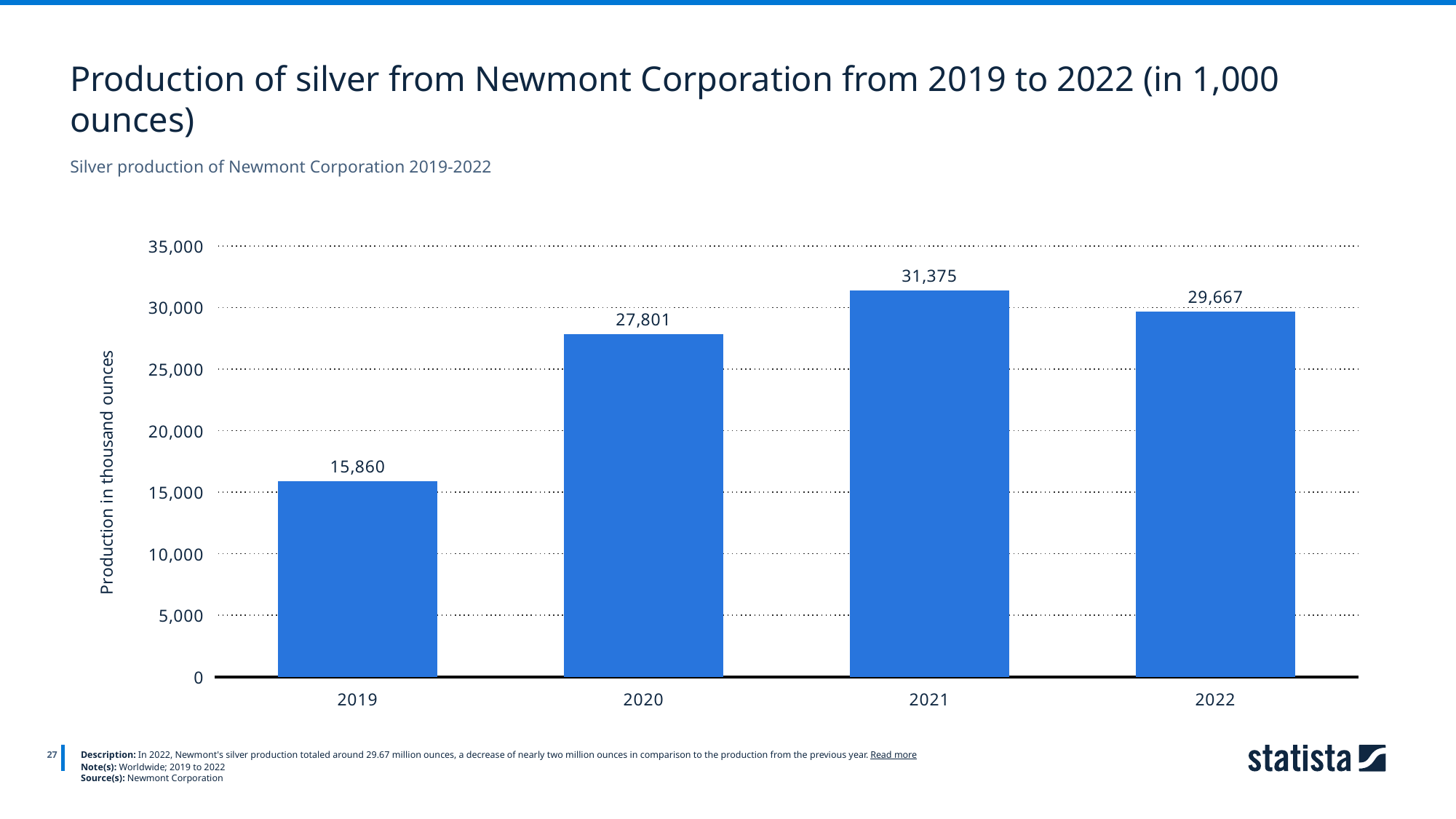
What is the difference in silver production between 2021 and 2022? 1,708 What was Newmont Corporation's silver production in 2021? 31,375 What was Newmont Corporation's silver production in 2022? 29,667 Which year had the highest silver production? 2021 Which year had the lowest silver production? 2019 How many years are shown in the chart? 4 What type of chart is shown on the slide? Bar chart What is the label of the y-axis? Production in thousand ounces Is the value for 2020 greater or less than 25,000? greater What is the difference in silver production between 2020 and 2019? 11,941 What was Newmont Corporation's silver production in 2019? 15,860 Which year had higher silver production, 2020 or 2022? 2022